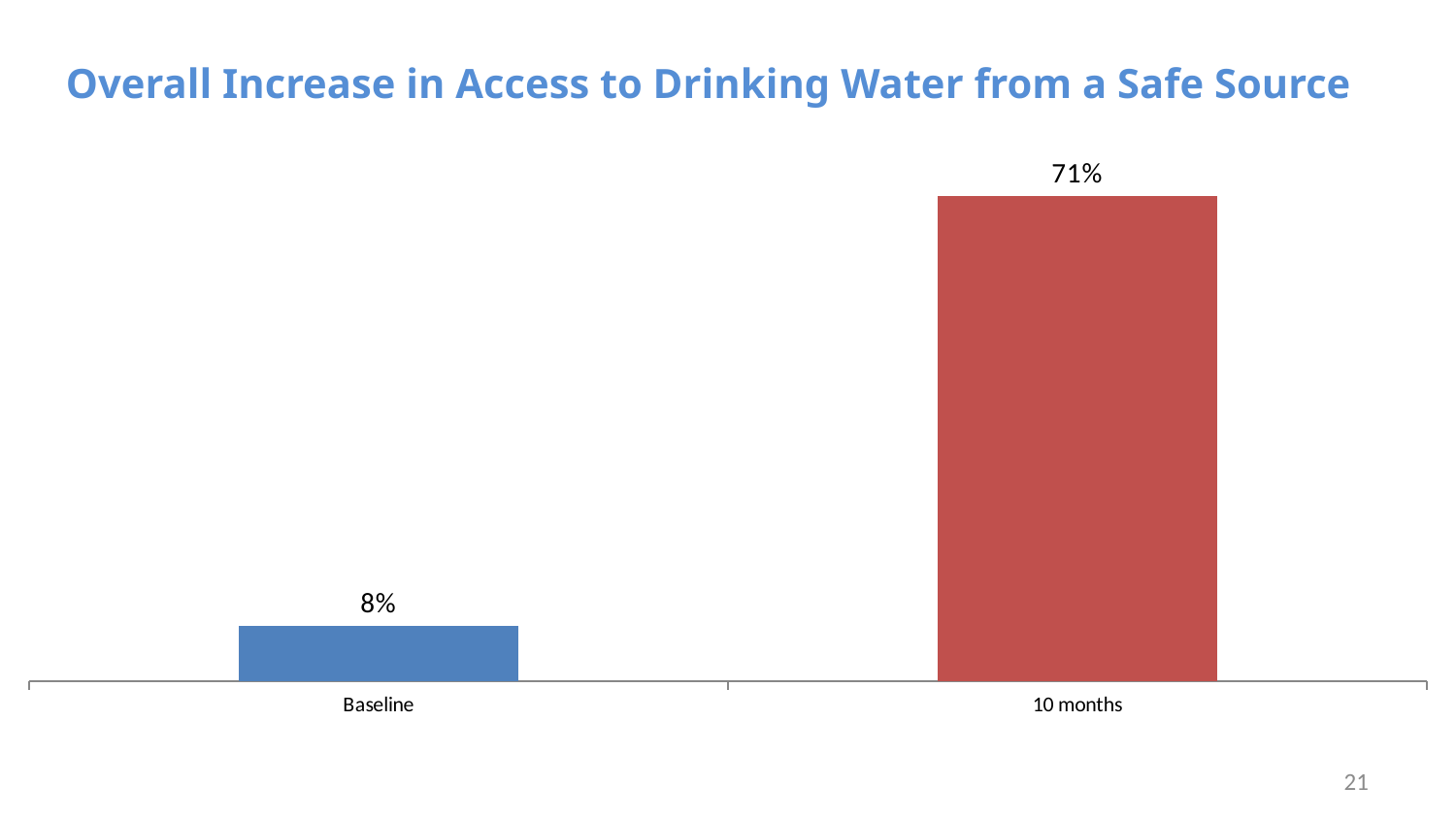
How many categories are shown on the x axis? 2 Which is larger, the value for Baseline or the value for 10 months? 10 months What is the title of the chart? Overall Increase in Access to Drinking Water from a Safe Source Which category has the lowest value? Baseline Which category has the highest value? 10 months What colour is the bar for 10 months? Red What is the value for 10 months? 71% What is the value for Baseline? 8% What kind of chart is shown on the slide? Bar chart What is the difference between the value at 10 months and the Baseline value? 63% Do the values rise or fall from Baseline to 10 months? Rise